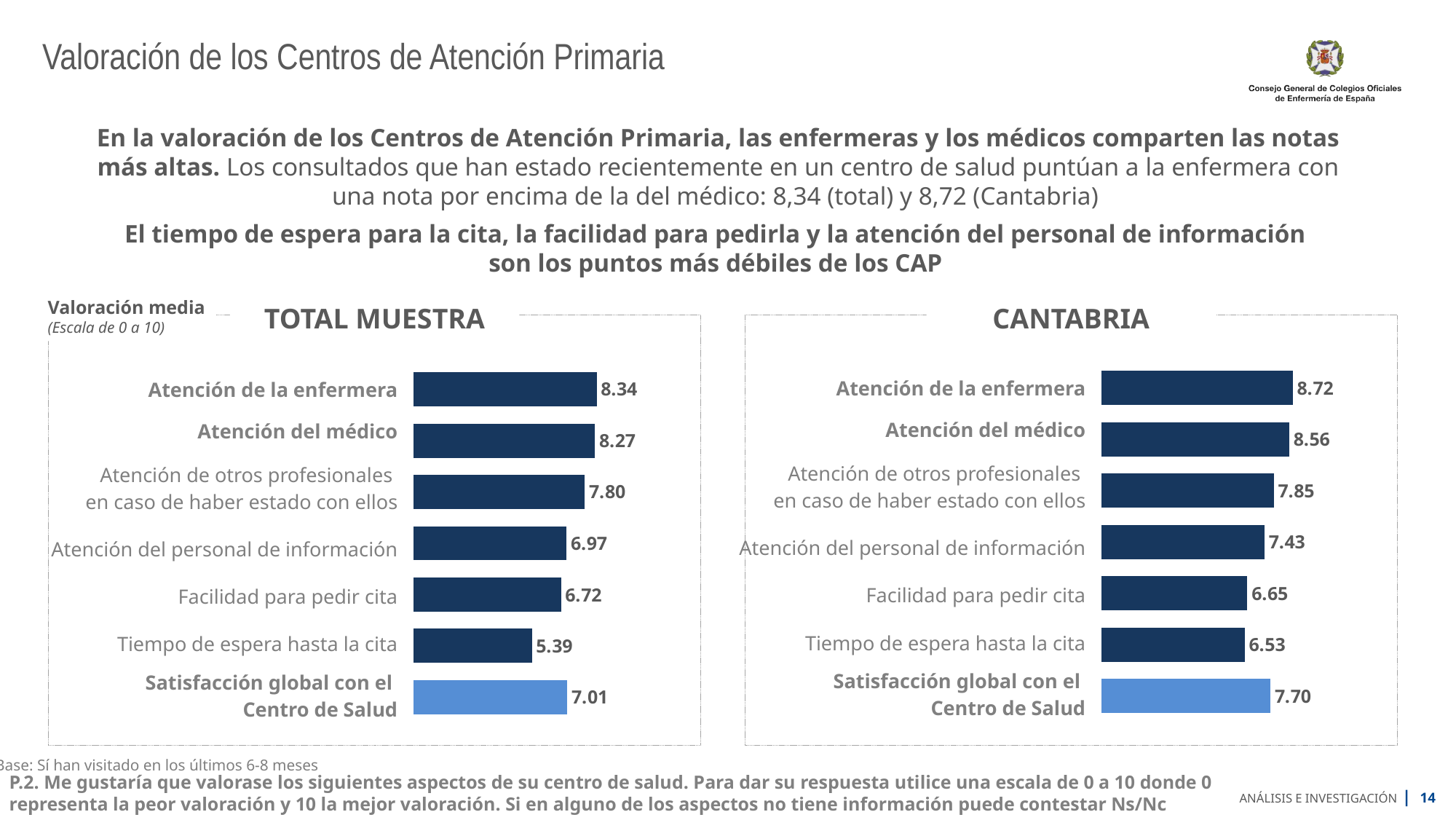
In the CANTABRIA chart, what is the value for Satisfacción global con el Centro de Salud? 7.70 In the TOTAL MUESTRA chart, which category has the highest value? Atención de la enfermera In the TOTAL MUESTRA chart, what is the value for Atención de la enfermera? 8.34 How many categories are shown in the CANTABRIA chart? 7 In the TOTAL MUESTRA chart, which category has the lowest value? Tiempo de espera hasta la cita What kind of chart is the TOTAL MUESTRA chart? Bar chart In the CANTABRIA chart, what is the value for Tiempo de espera hasta la cita? 6.53 In the CANTABRIA chart, which category has the lowest value? Tiempo de espera hasta la cita In the CANTABRIA chart, what is the difference between Atención de la enfermera and Atención del médico? 0.16 In the TOTAL MUESTRA chart, which bar is shown in a lighter blue colour than the others? Satisfacción global con el Centro de Salud Which is larger: Facilidad para pedir cita in the TOTAL MUESTRA chart or in the CANTABRIA chart? TOTAL MUESTRA In the TOTAL MUESTRA chart, what is the difference between Atención del personal de información and Facilidad para pedir cita? 0.25